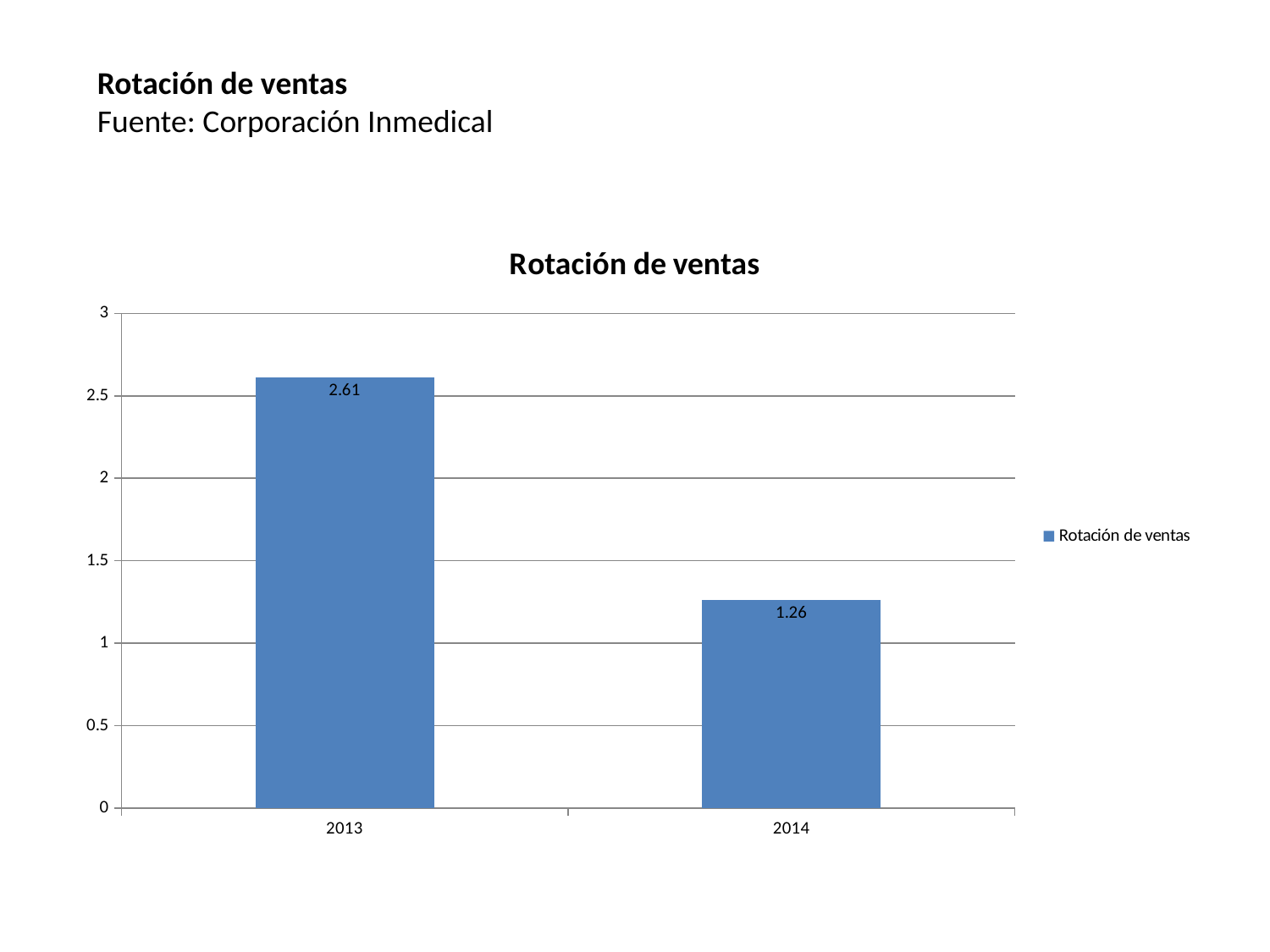
Do the values rise or fall from 2013 to 2014? fall What is the difference between the values for 2013 and 2014? 1.35 What is the value for 2014? 1.26 Is the value for 2013 greater or less than 2.5? greater What kind of chart is shown? bar chart Which is larger, the value for 2013 or the value for 2014? 2013 How many years are shown on the x axis? 2 Is the value for 2014 greater or less than 1.5? less Which year has the lowest value? 2014 How many series does the legend list? 1 What is the value for 2013? 2.61 Which year has the highest value? 2013